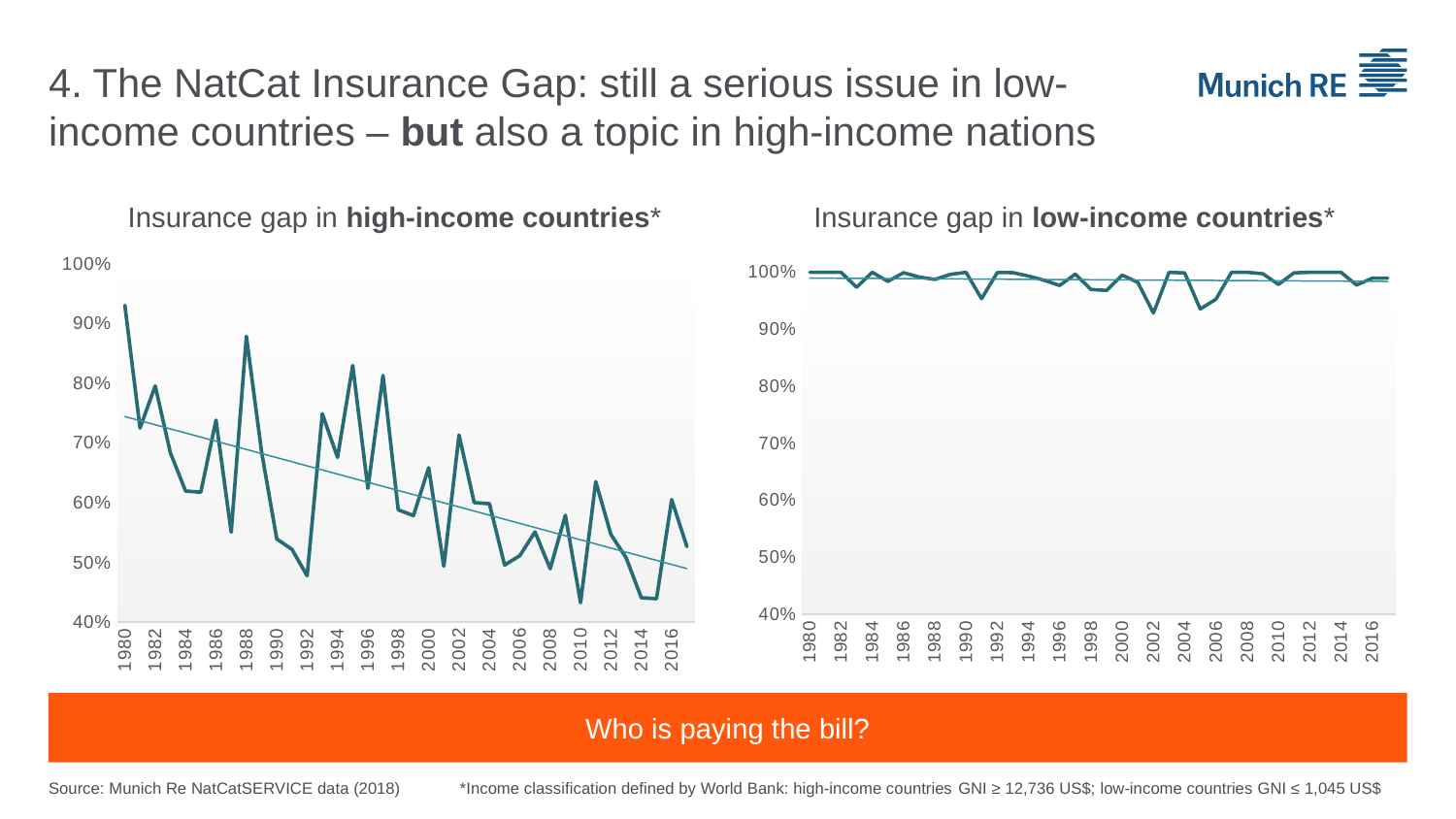
In the 'Insurance gap in high-income countries' chart, which year has the larger value, 1980 or 2010? 1980 In the 'Insurance gap in high-income countries' chart, do the values generally rise or fall from 1980 to 2016? fall What kind of chart is the 'Insurance gap in low-income countries' chart? line chart In the 'Insurance gap in low-income countries' chart, is the value for 1990 greater or less than 80%? greater In the 'Insurance gap in high-income countries' chart, is the value for 2010 greater or less than 50%? less In the 'Insurance gap in low-income countries' chart, is the value for 2002 greater or less than 90%? greater What kind of chart is the 'Insurance gap in high-income countries' chart? line chart In the 'Insurance gap in high-income countries' chart, which year has the larger value, 1988 or 1992? 1988 What is the first year shown on the x axis of the 'Insurance gap in high-income countries' chart? 1980 Which chart shows consistently higher insurance gap values, the high-income countries chart or the low-income countries chart? low-income countries